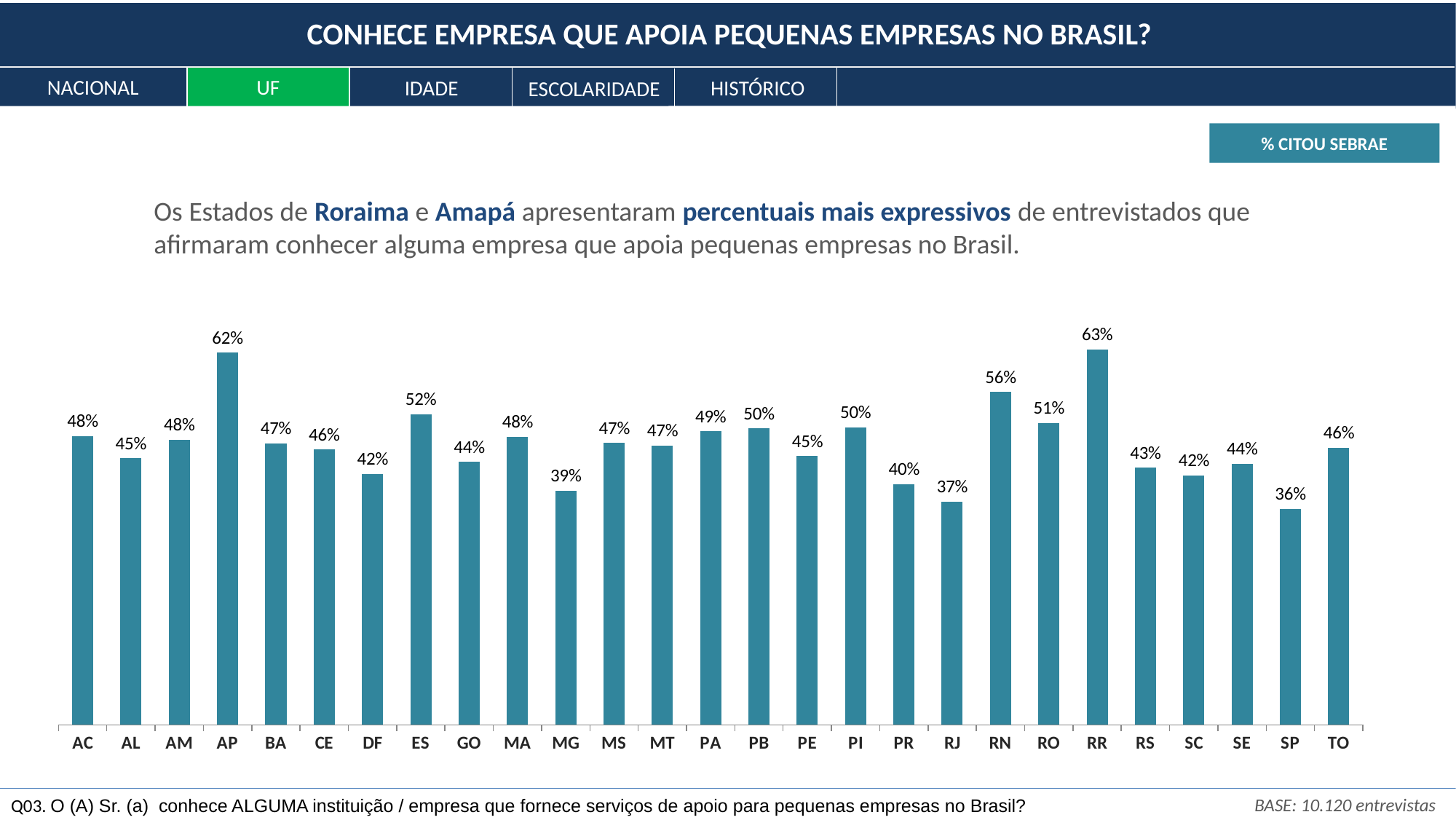
What does the label in the box at the top right of the chart say? % CITOU SEBRAE Which is larger, the value for RO or the value for PB? RO What kind of chart is shown on the slide? Bar chart Which state has the lowest value? SP What is the value for SP? 36% How many states are shown on the x axis? 27 What is the difference between the values for RR and AP? 1% What is the value for RN? 56% What is the difference between the values for ES and RJ? 15% What is the value for AP? 62% What is the value for MG? 39% Which state has the highest value? RR